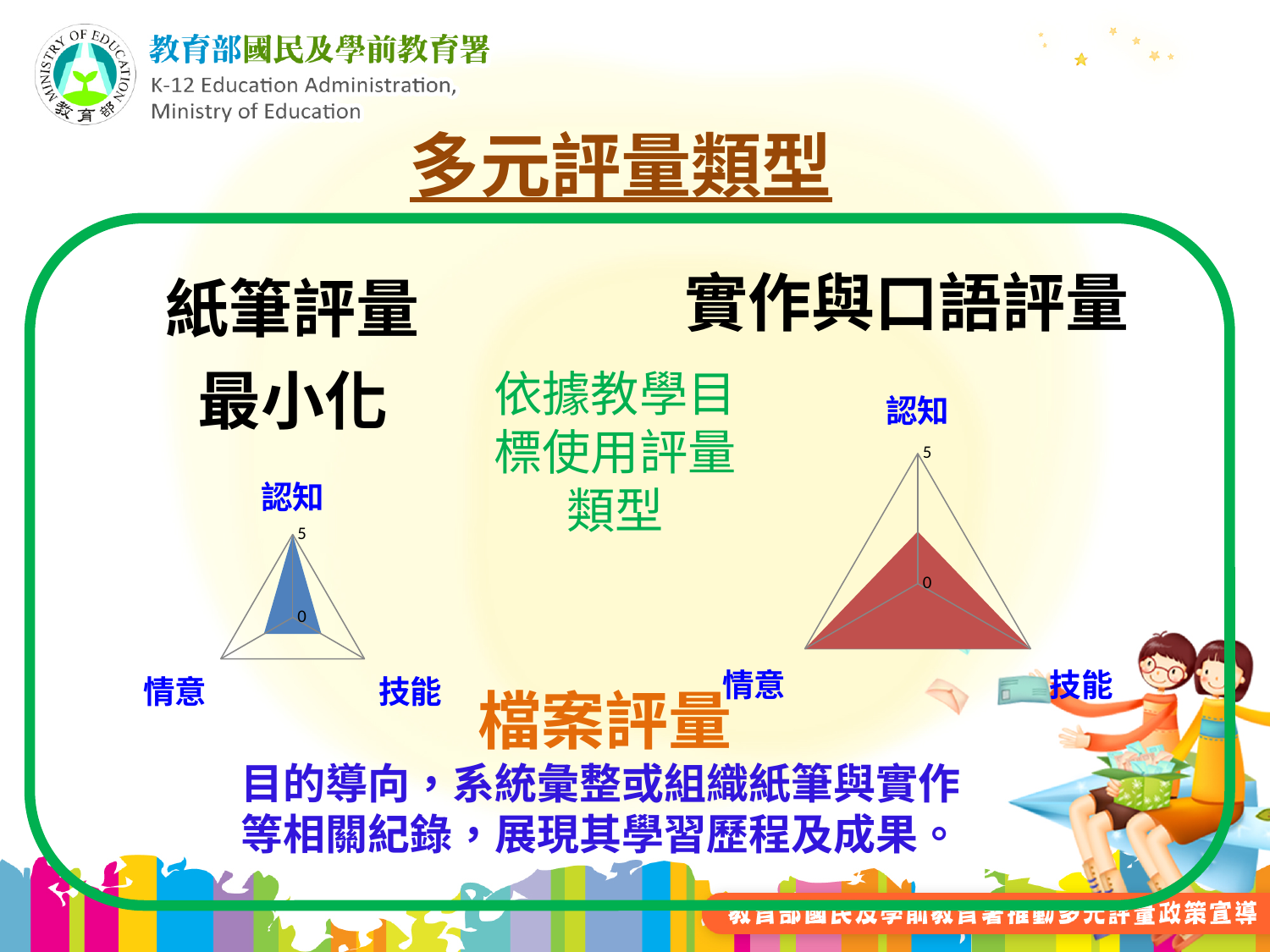
In the left radar chart under 紙筆評量, which category has the highest value? 認知 In the left radar chart under 紙筆評量, which is larger, the value for 認知 or the value for 情意? 認知 In the right radar chart under 實作與口語評量, which category has the lowest value? 認知 In the right radar chart under 實作與口語評量, is the value for 認知 greater or less than 5? less What kind of chart is shown under the heading 實作與口語評量 on the right of the slide? radar chart What kind of chart is shown under the heading 紙筆評量 on the left of the slide? radar chart In the right radar chart under 實作與口語評量, which is larger, the value for 技能 or the value for 認知? 技能 How many categories (axes) does the left radar chart under 紙筆評量 have? 3 What is the maximum axis tick value shown on the left radar chart under 紙筆評量? 5 In the left radar chart under 紙筆評量, which is larger, the value for 認知 or the value for 技能? 認知 What colour is the filled data area in the right radar chart under 實作與口語評量? red